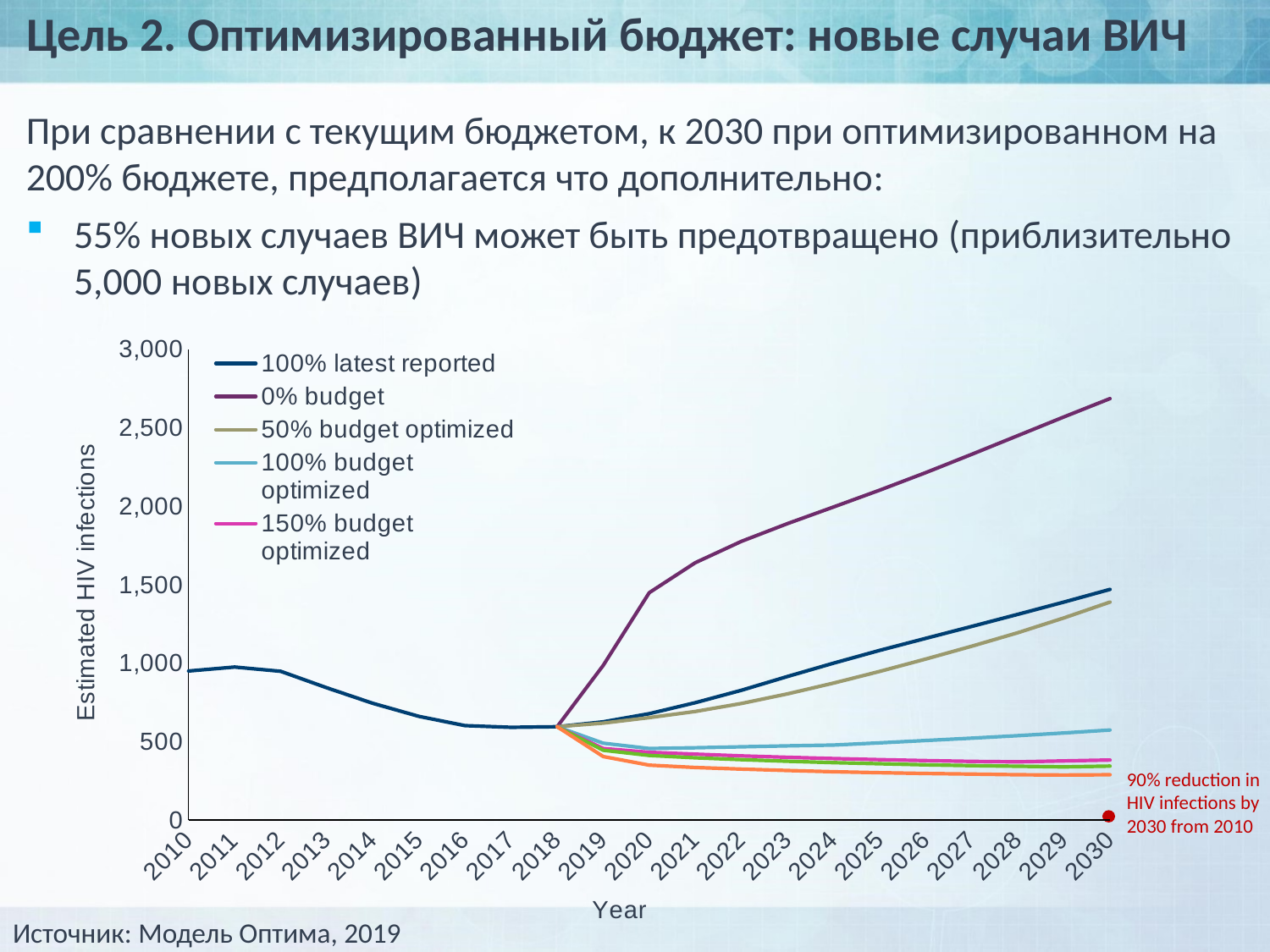
How many series does the chart's legend list? 5 How many years are marked along the x axis of the chart? 21 What is the title of the chart's vertical axis? Estimated HIV infections In 2030, which is larger: the 100% budget optimized series or the 150% budget optimized series? 100% budget optimized Does the 0% budget series rise or fall from 2018 to 2030? Rises In 2030, which is larger: the 0% budget series or the 100% latest reported series? 0% budget Is the value of the 100% budget optimized series in 2030 greater or less than 500? greater Is the value of the 50% budget optimized series in 2030 greater or less than 1,500? less Which series has the highest value in 2030? 0% budget Is the value of the 0% budget series in 2030 greater or less than 2,500? greater What kind of chart is shown on the slide? Line chart